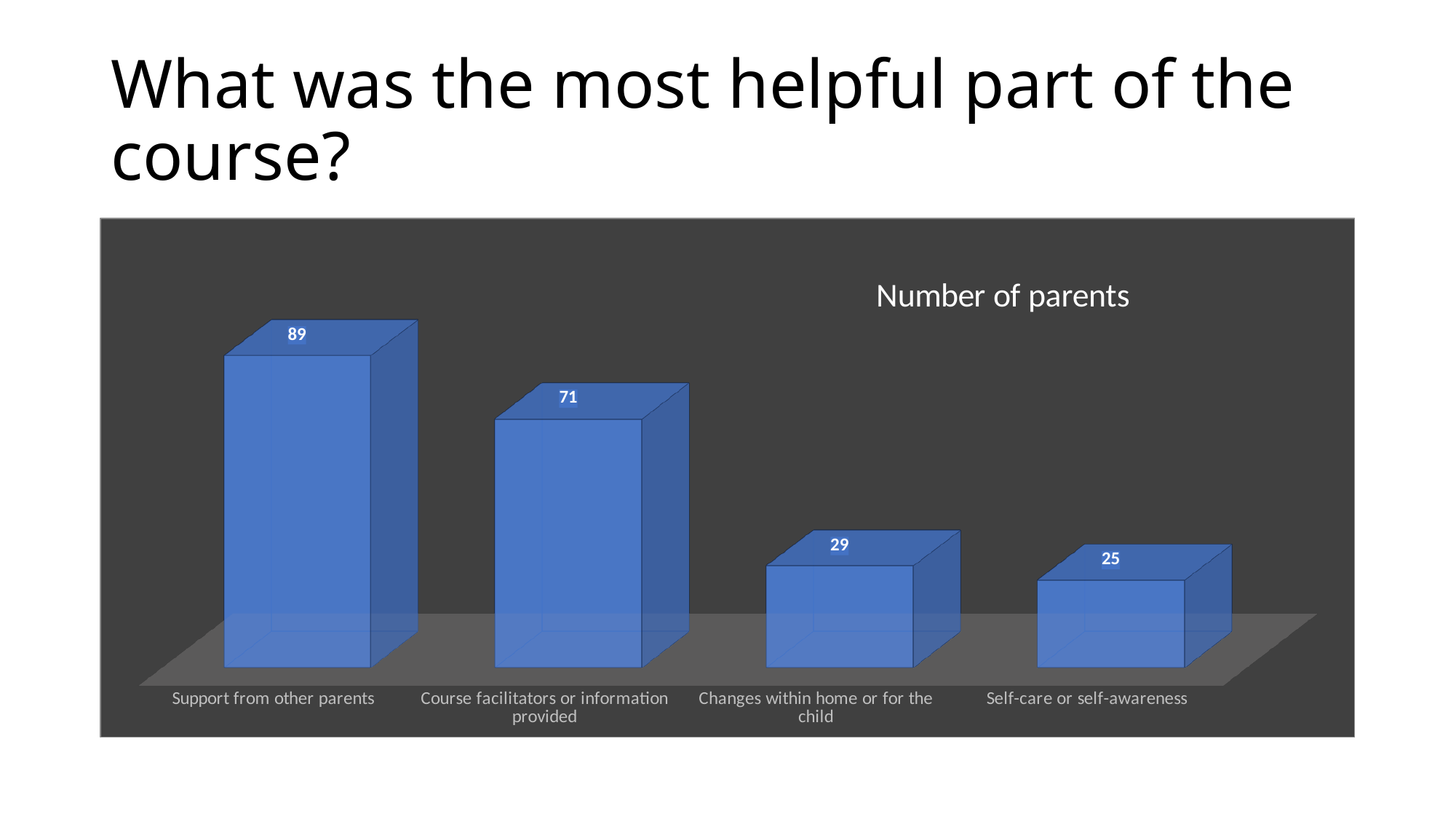
What is the value for 'Changes within home or for the child'? 29 What is the difference between the values for 'Support from other parents' and 'Course facilitators or information provided'? 18 Which category has the highest number of parents? Support from other parents How many categories are shown in the chart? 4 Which category has the lowest number of parents? Self-care or self-awareness What kind of chart is shown on the slide? Bar chart How many parents chose 'Support from other parents' as the most helpful part of the course? 89 What is the difference between the values for 'Changes within home or for the child' and 'Self-care or self-awareness'? 4 What is the value for 'Course facilitators or information provided'? 71 What is the value for 'Self-care or self-awareness'? 25 What is the title of the chart? Number of parents Which is larger: the value for 'Course facilitators or information provided' or the value for 'Changes within home or for the child'? Course facilitators or information provided